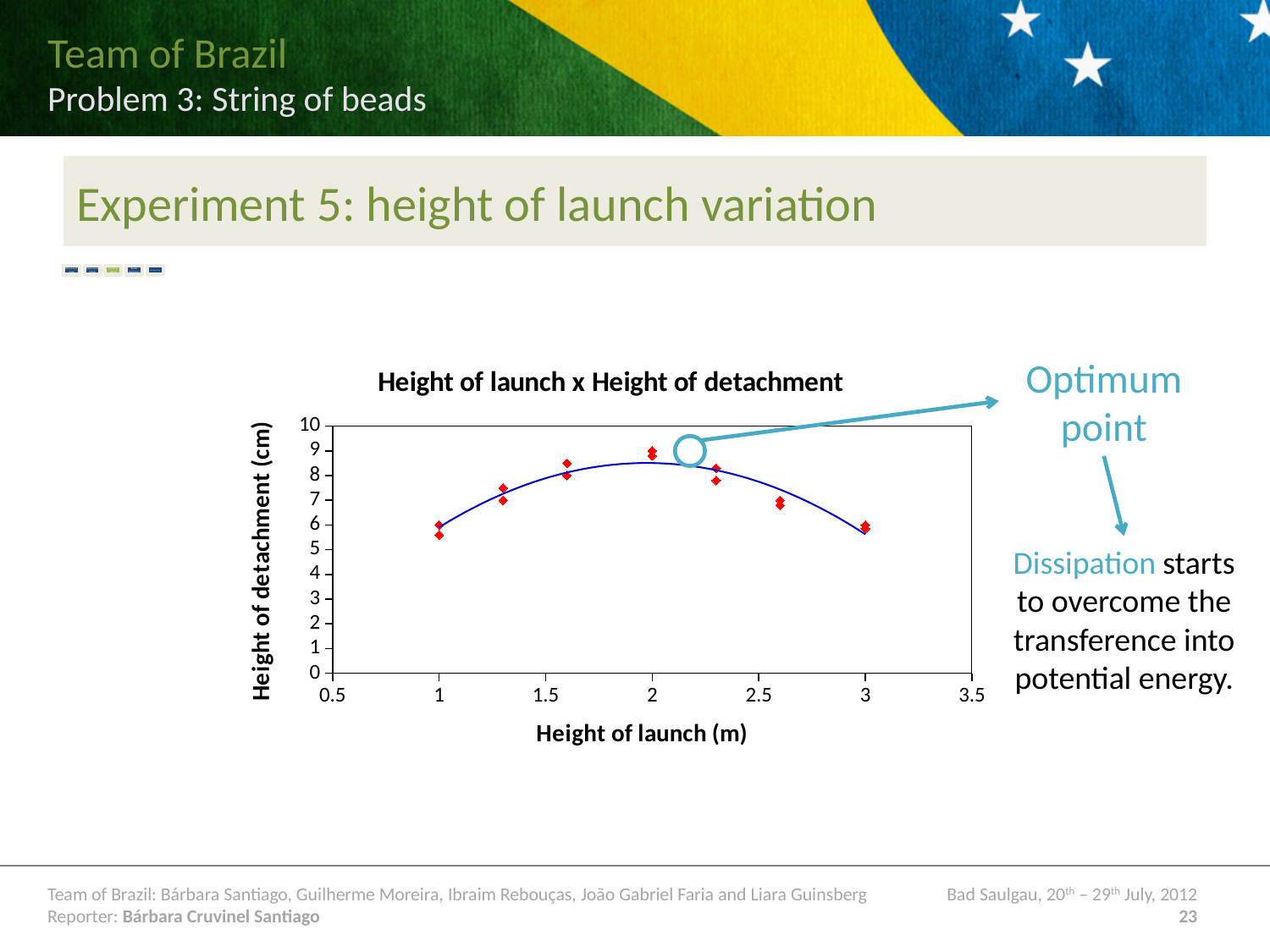
At which height of launch is the height of detachment highest? 2 Is the height of detachment at a launch height of 1 m greater or less than 7? less Which launch height gives a larger height of detachment, 1.6 m or 3 m? 1.6 m How does the height of detachment change as the height of launch increases from 2 m to 3 m? it falls Is the height of detachment at a launch height of 1.6 m greater or less than 7? greater Is the height of detachment at a launch height of 3 m greater or less than 7? less How many distinct heights of launch were measured in the chart? 7 What is the label of the vertical axis of the chart? Height of detachment (cm) What is the title of the chart? Height of launch x Height of detachment Which launch height gives a larger height of detachment, 1 m or 2 m? 2 m What kind of chart is shown on the slide? scatter chart